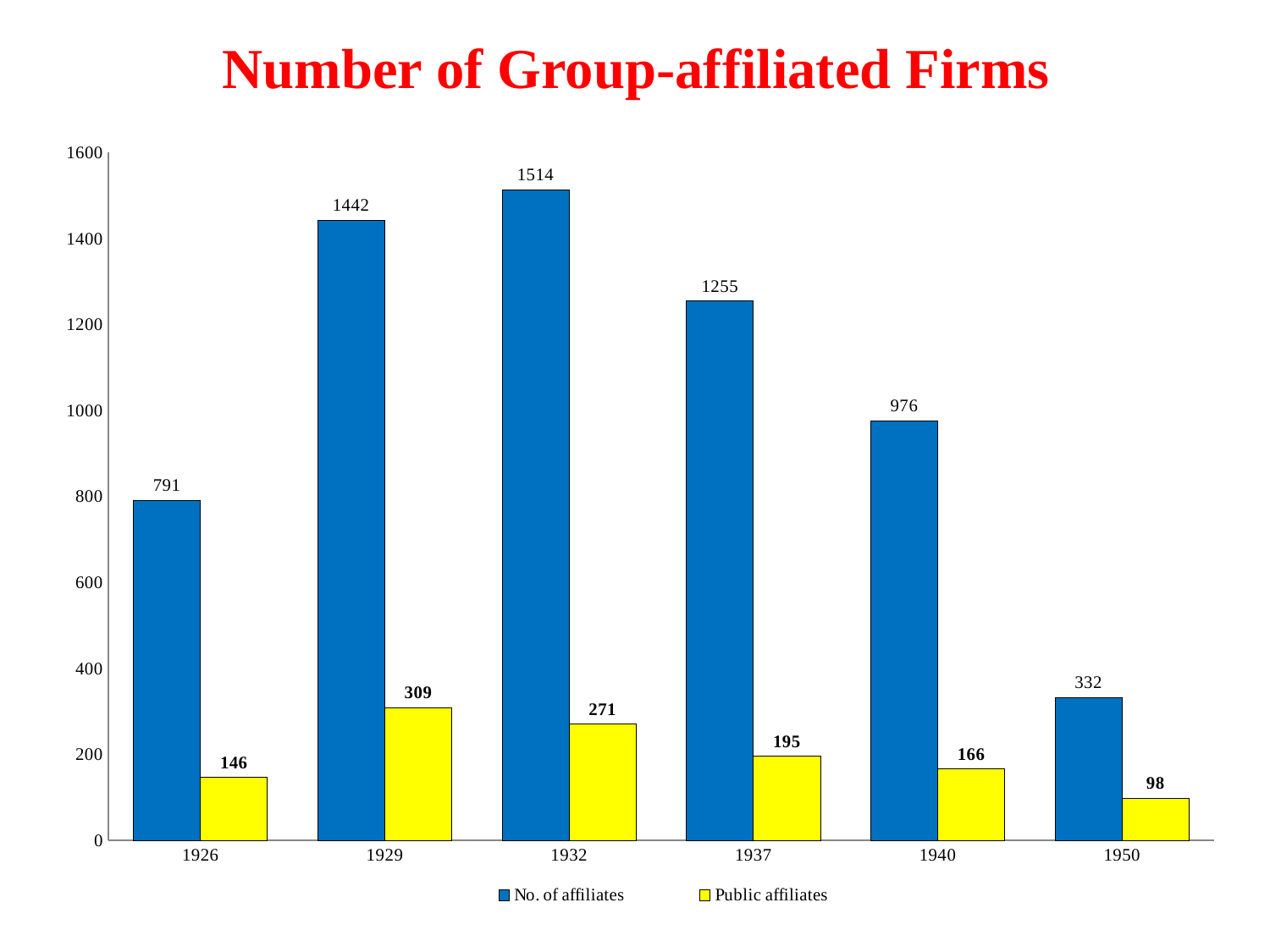
What is the title of the chart? Number of Group-affiliated Firms What is the number of affiliates in 1932? 1514 What is the difference between the number of affiliates in 1929 and in 1937? 187 What kind of chart is shown on the slide? bar chart Is the number of affiliates in 1940 greater or less than 1000? less Does the number of affiliates rise or fall from 1932 to 1950? fall Which year has the lowest number of public affiliates? 1950 How many years are shown on the x axis? 6 Which year has the highest number of affiliates? 1932 How many series does the legend list? 2 What is the number of public affiliates in 1929? 309 Which is larger: the number of public affiliates in 1937 or in 1940? 1937